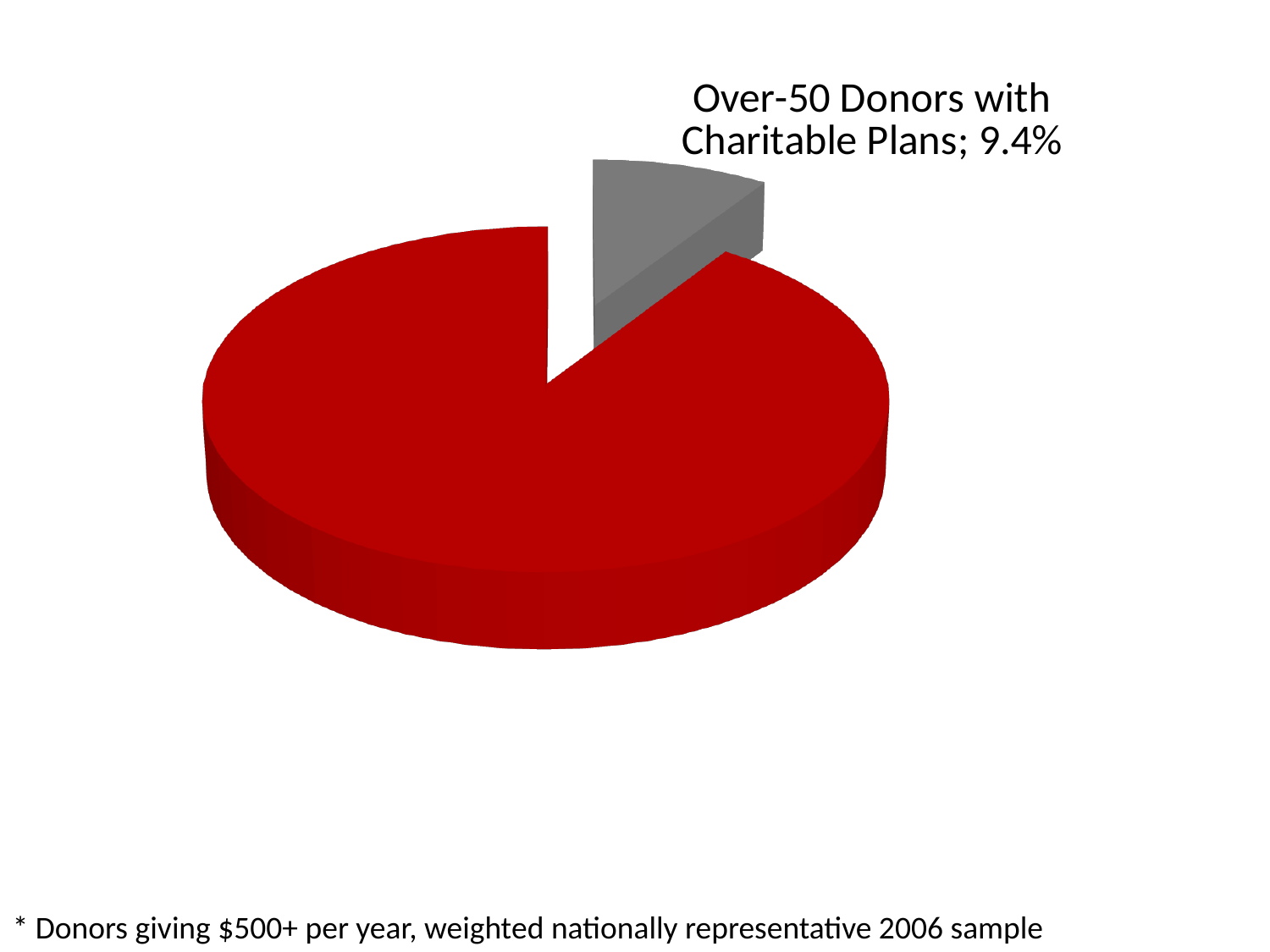
What percentage is shown for Over-50 Donors with Charitable Plans? 9.4% How many slices does the pie chart have? 2 Which slice is larger, the gray slice or the red slice? the red slice What colour is the slice labelled Over-50 Donors with Charitable Plans? gray According to the footnote, what minimum annual giving amount defines the donors in the sample? $500+ per year What kind of chart is shown on the slide? pie chart What share of the pie does the Over-50 Donors with Charitable Plans slice represent? 9.4% Which slice of the pie is the smallest? Over-50 Donors with Charitable Plans